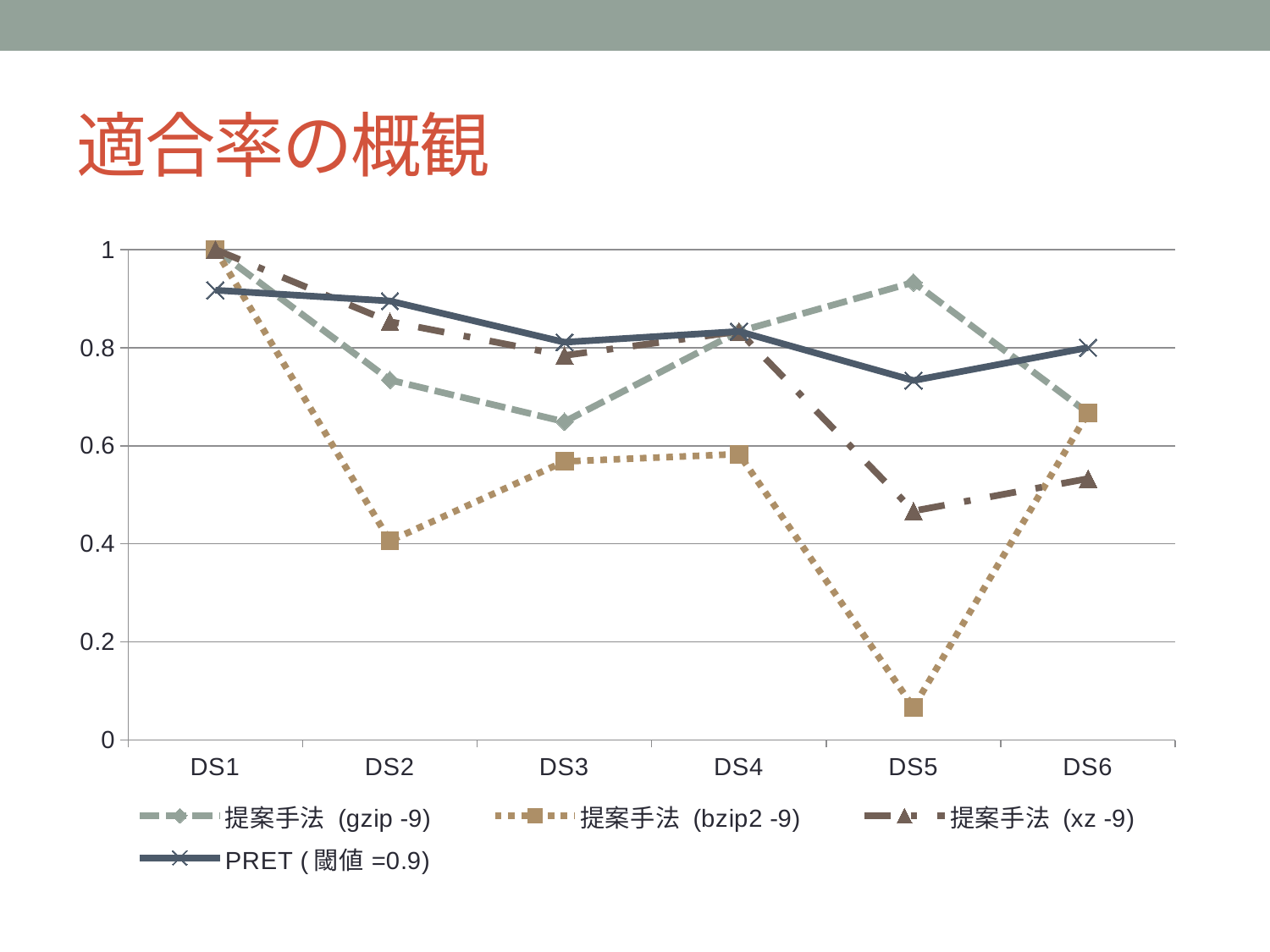
Is the value of 提案手法 (xz -9) at DS5 greater or less than 0.6? less What is the title of the slide containing the chart? 適合率の概観 At DS5, which is larger: 提案手法 (gzip -9) or 提案手法 (bzip2 -9)? 提案手法 (gzip -9) Is the value of 提案手法 (gzip -9) at DS5 greater or less than 0.8? greater What kind of chart is shown on the slide? line chart At which category does 提案手法 (bzip2 -9) reach its lowest value? DS5 What is the value of 提案手法 (bzip2 -9) at DS1? 1 How many series does the legend list? 4 Does the value of 提案手法 (bzip2 -9) rise or fall from DS4 to DS5? fall At which category does 提案手法 (gzip -9) reach its lowest value? DS3 How many categories are shown on the x axis? 6 Is the value of 提案手法 (bzip2 -9) at DS5 greater or less than 0.2? less